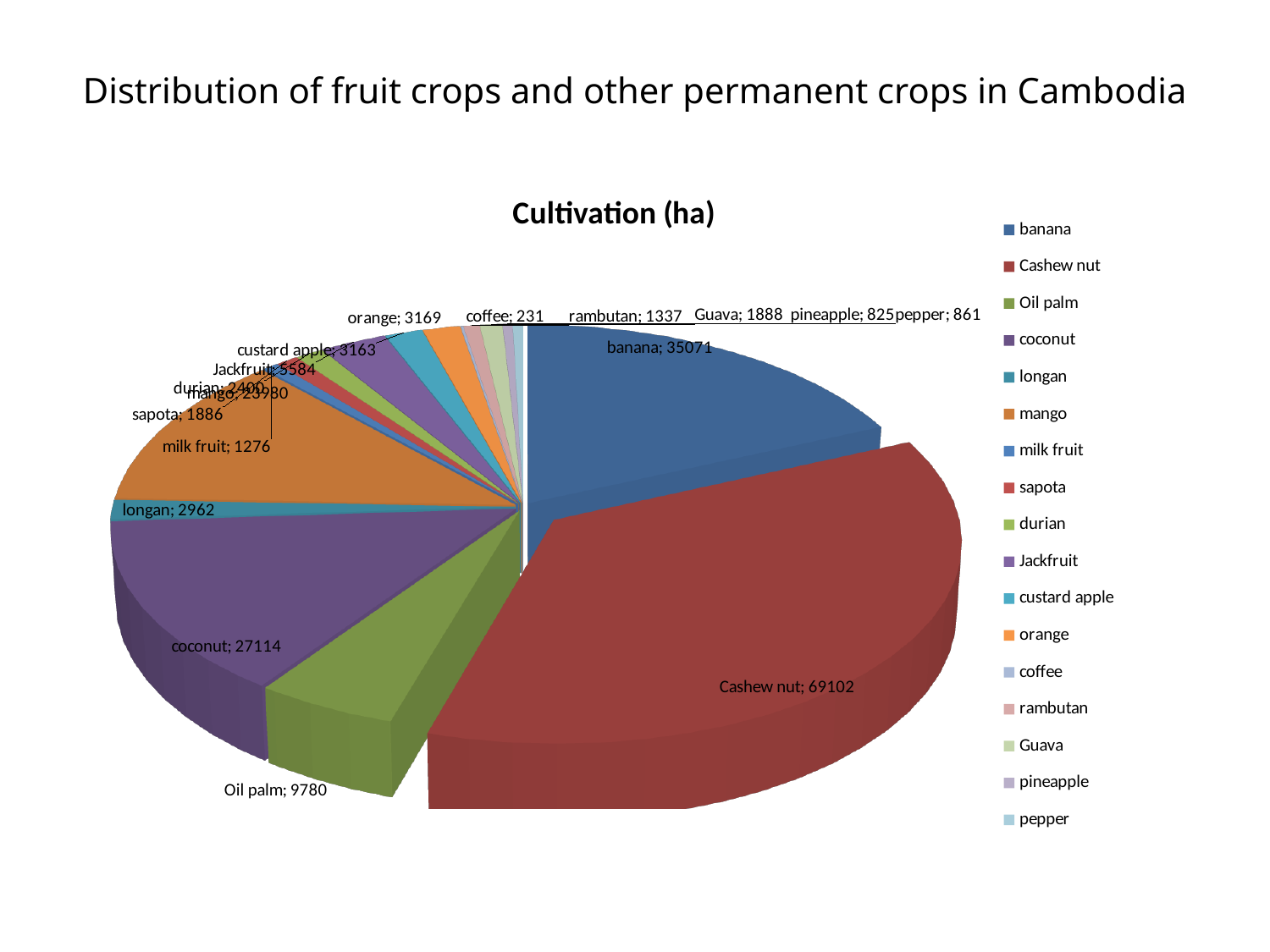
What is the cultivation value for Cashew nut? 69102 How many crops are listed in the legend? 17 What is the title of the pie chart? Cultivation (ha) What is the cultivation value for banana? 35071 What is the cultivation value for coffee? 231 What kind of chart is shown on the slide? pie chart Which crop has the largest slice of the pie? Cashew nut Which has a larger cultivation value, coconut or Oil palm? coconut What is the cultivation value for coconut? 27114 What is the difference between the cultivation values for Cashew nut and banana? 34031 Which crop has the smallest cultivation value? coffee What is the cultivation value for Oil palm? 9780